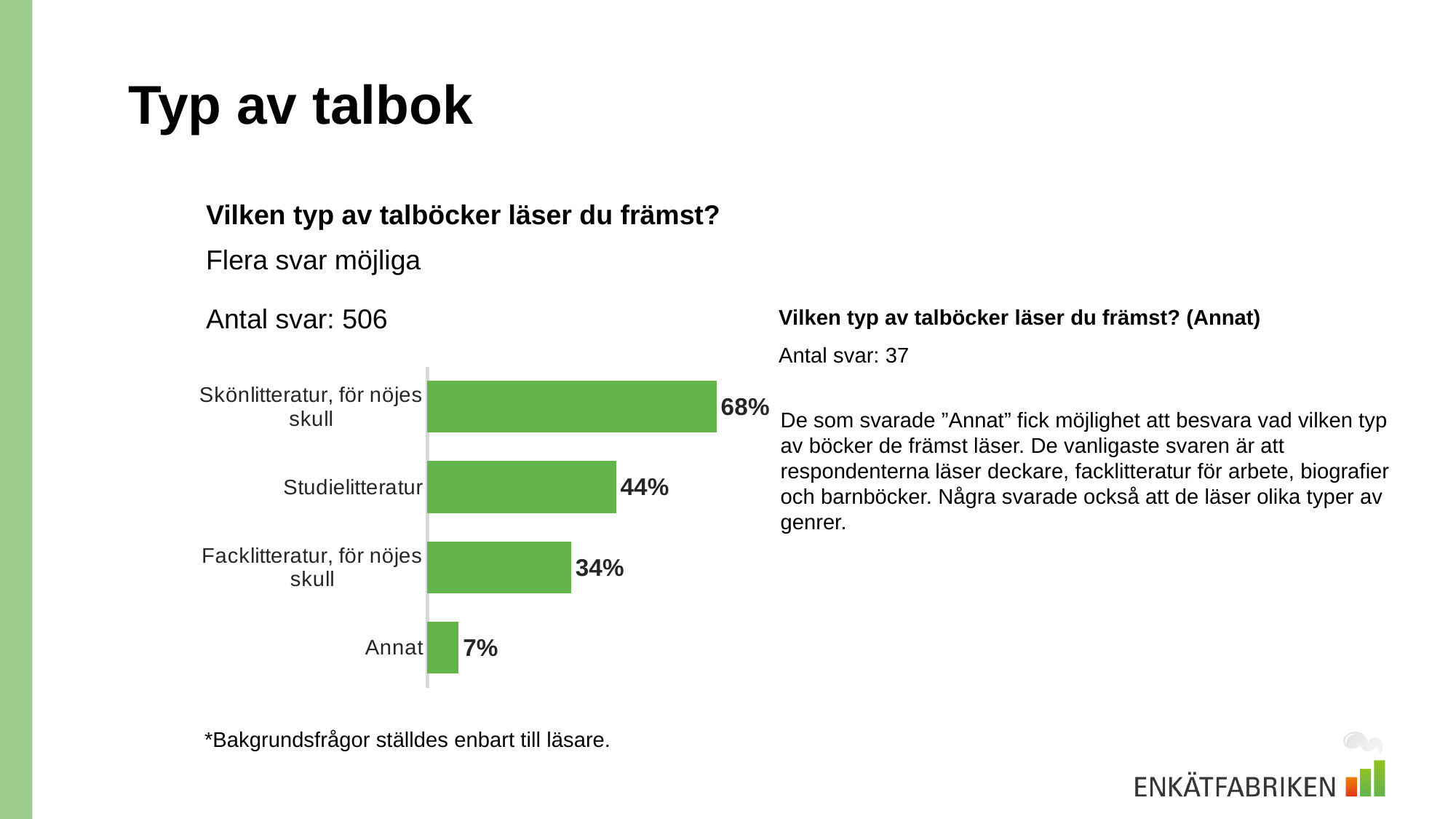
What is the value for Skönlitteratur, för nöjes skull? 68% Which category has the lowest value? Annat What is the value for Facklitteratur, för nöjes skull? 34% What is the difference between the values for Skönlitteratur, för nöjes skull and Studielitteratur? 24% What is the number of responses (Antal svar) stated above the chart? 506 Which category has the highest value? Skönlitteratur, för nöjes skull What is the value for Studielitteratur? 44% What is the difference between the values for Studielitteratur and Facklitteratur, för nöjes skull? 10% Which is larger, the value for Studielitteratur or the value for Facklitteratur, för nöjes skull? Studielitteratur What kind of chart is shown on the slide? Bar chart What is the value for Annat? 7% How many categories are shown in the chart? 4